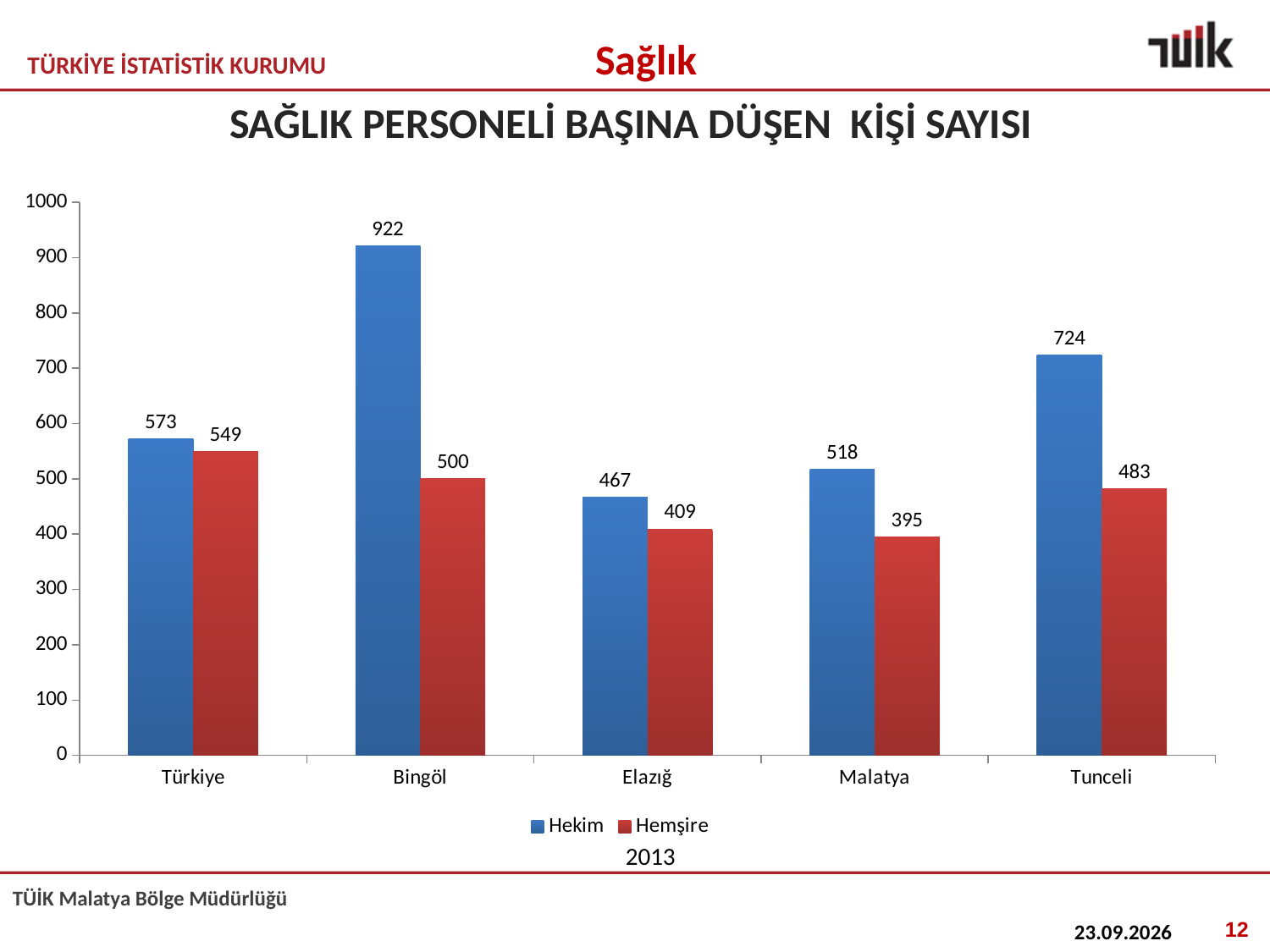
What is the Hemşire value for Malatya? 395 How many categories are shown on the x axis? 5 What is the title of the chart? SAĞLIK PERSONELİ BAŞINA DÜŞEN KİŞİ SAYISI What kind of chart is shown on the slide? bar chart What is the Hekim value for Türkiye? 573 How many series does the legend list? 2 Which category has the lowest Hemşire value? Malatya What is the Hekim value for Bingöl? 922 Is the Hemşire value for Bingöl greater or less than 600? less Which is larger, the Hekim value for Elazığ or the Hekim value for Malatya? Malatya What is the difference between the Hekim and Hemşire values for Tunceli? 241 Which category has the highest Hekim value? Bingöl